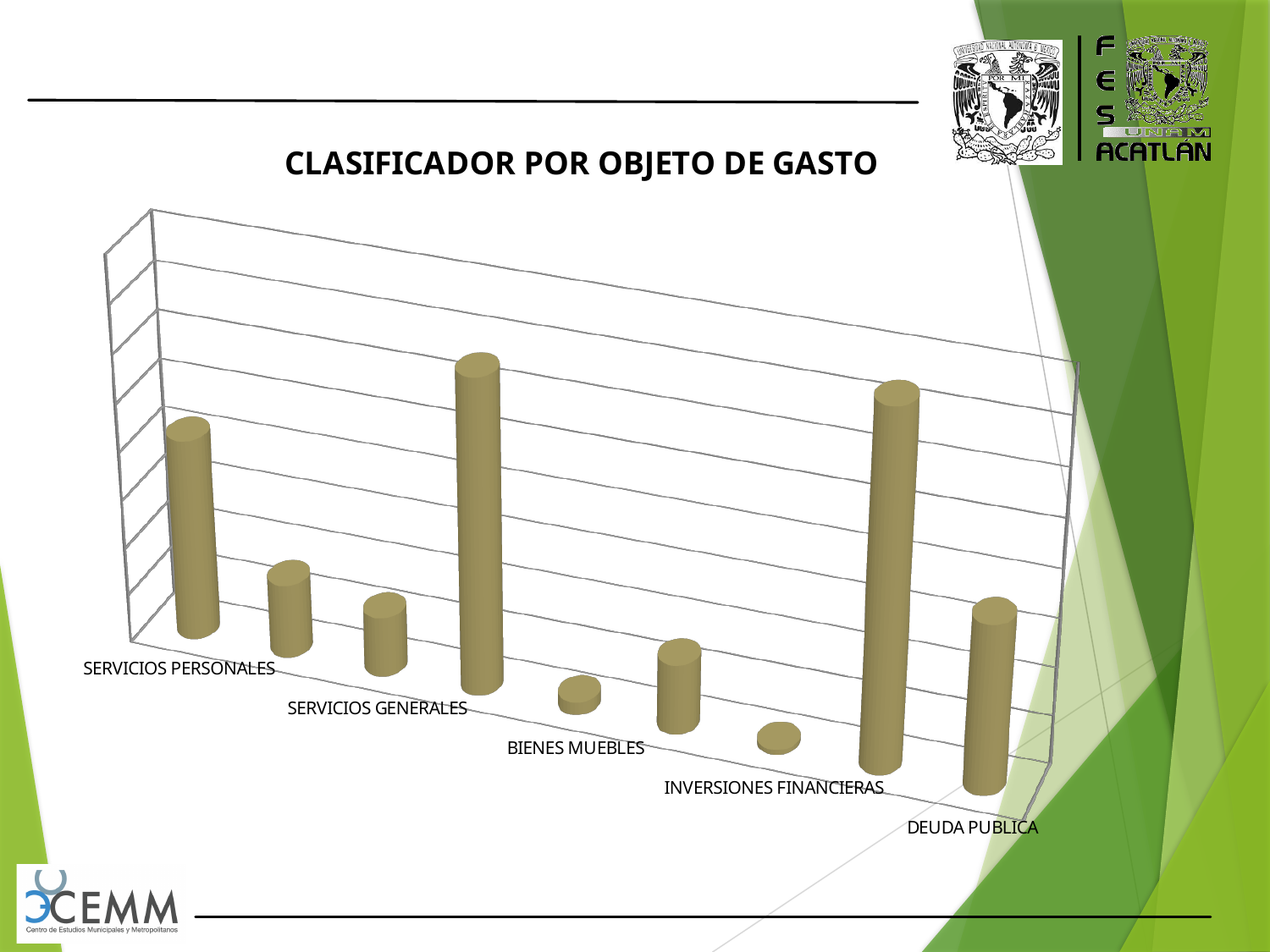
What colour are the bars in the chart? Tan (gold) Which is larger, the value for DEUDA PUBLICA or the value for BIENES MUEBLES? DEUDA PUBLICA Which is larger, the value for DEUDA PUBLICA or the value for SERVICIOS GENERALES? DEUDA PUBLICA Which of the labelled categories has the lowest bar? INVERSIONES FINANCIERAS What is the title of the chart? CLASIFICADOR POR OBJETO DE GASTO What kind of chart is shown on the slide? Bar chart How many bars are plotted in the chart? 9 Do the values rise steadily, fall steadily, or fluctuate from left to right across the chart? Fluctuate Which is larger, the value for SERVICIOS PERSONALES or the value for SERVICIOS GENERALES? SERVICIOS PERSONALES